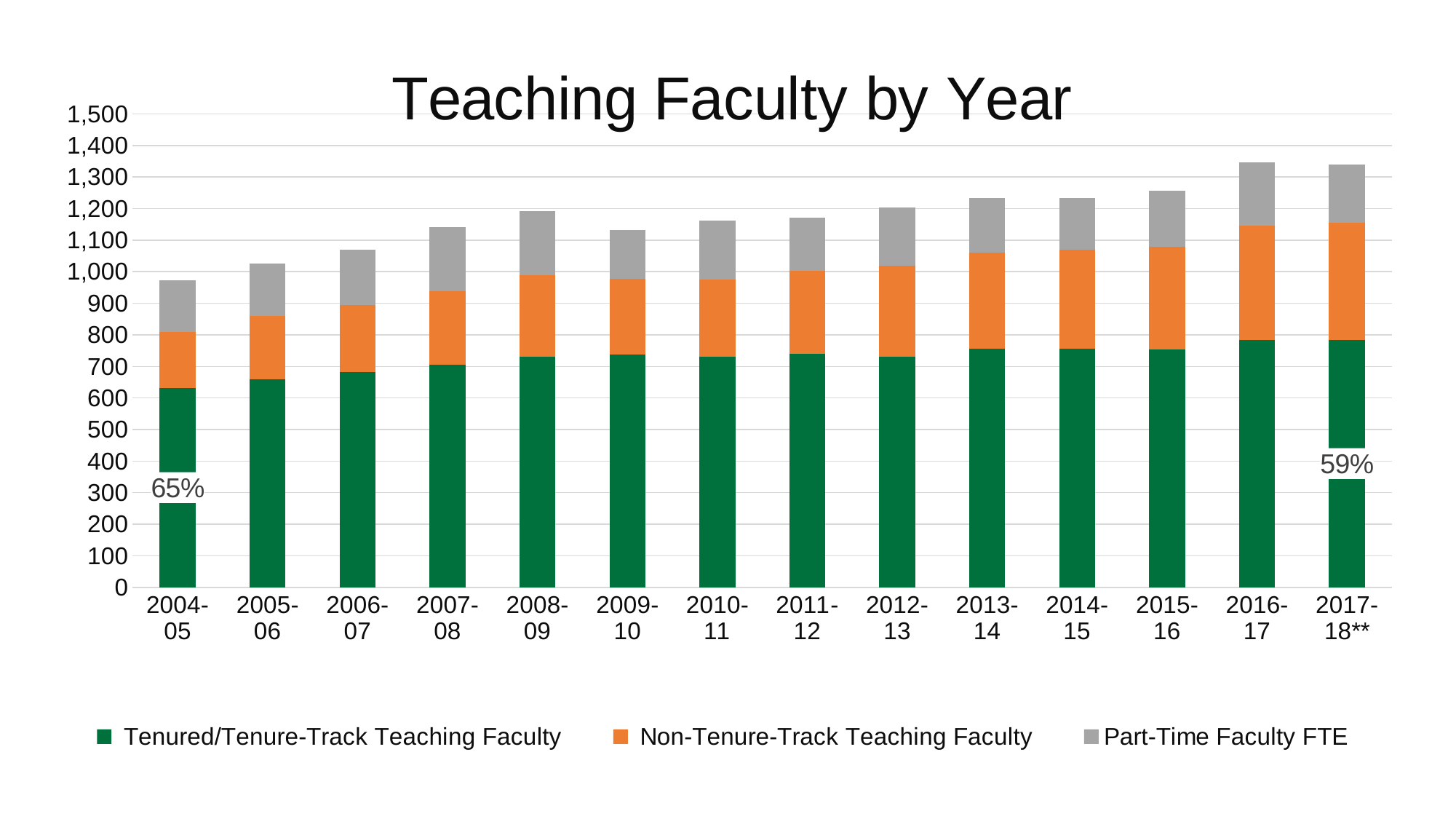
How many academic years are shown on the x axis? 14 Is the total height of the 2016-17 bar greater or less than 1,300? greater What percentage label is printed on the 2004-05 bar? 65% What kind of chart is shown on the slide? bar chart Which has the taller total bar, 2008-09 or 2009-10? 2008-09 What is the title of the chart? Teaching Faculty by Year Is the Tenured/Tenure-Track Teaching Faculty value for 2004-05 greater or less than 700? less Which academic year has the lowest total bar? 2004-05 Is the total height of the 2004-05 bar greater or less than 1,000? less What percentage label is printed on the 2017-18** bar? 59% How many series does the legend list? 3 Does the Tenured/Tenure-Track Teaching Faculty segment generally rise or fall from 2004-05 to 2017-18**? rise